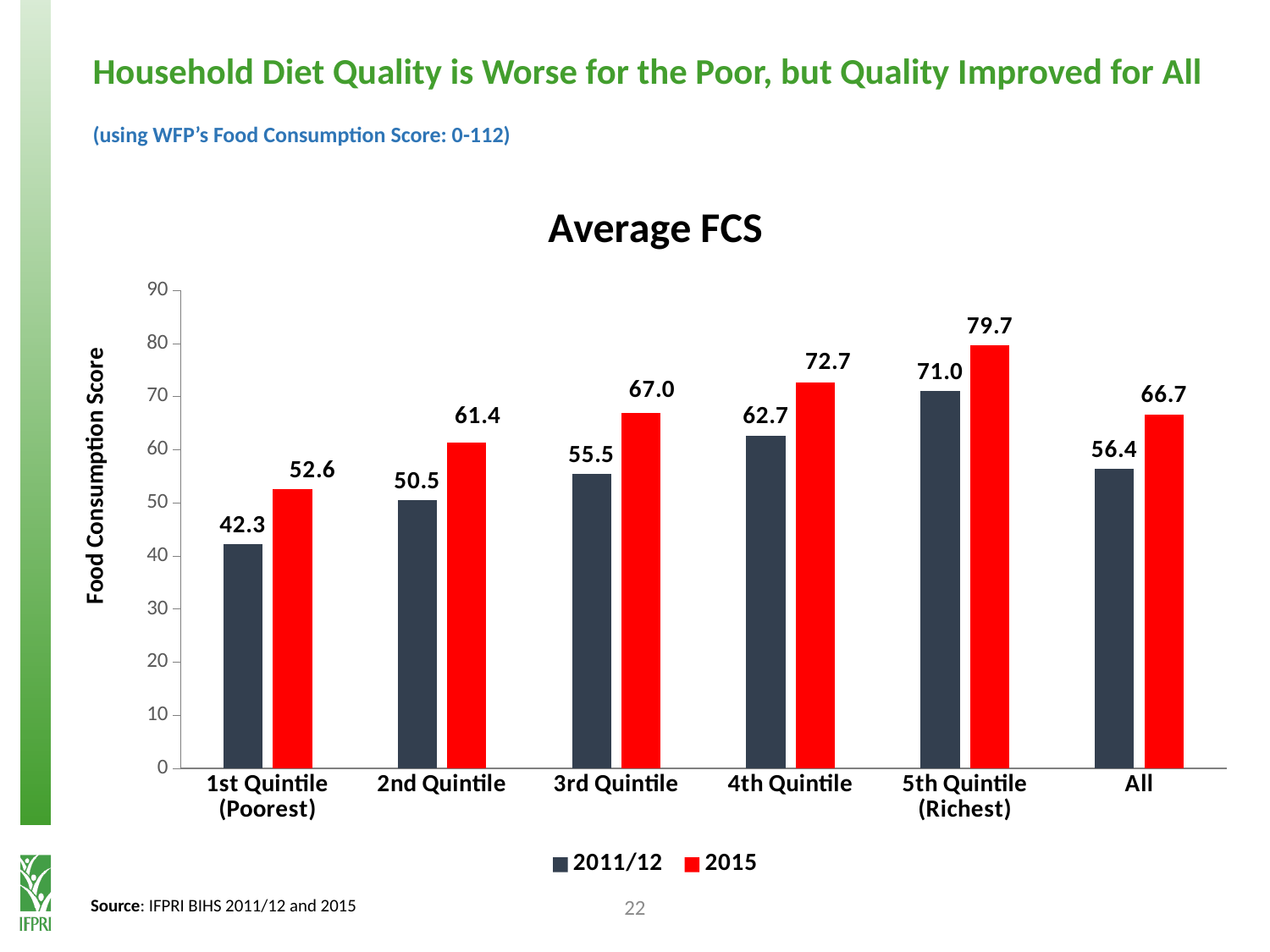
What kind of chart is the Average FCS chart? bar chart What is the 2015 Average FCS value for All households? 66.7 Which category has the lowest 2015 Average FCS value? 1st Quintile (Poorest) Which is larger: the 2015 value for the 2nd Quintile or the 2011/12 value for the 4th Quintile? 2011/12 value for the 4th Quintile How many categories are shown on the x axis of the Average FCS chart? 6 What is the 2011/12 Average FCS value for the 1st Quintile (Poorest)? 42.3 How many series does the legend of the Average FCS chart list? 2 What is the 2015 Average FCS value for the 5th Quintile (Richest)? 79.7 Is the 2011/12 Average FCS value for the 2nd Quintile greater or less than 60? less Which category has the highest 2011/12 Average FCS value? 5th Quintile (Richest) What is the label of the y axis on the Average FCS chart? Food Consumption Score What is the difference between the 2015 and 2011/12 Average FCS values for the 3rd Quintile? 11.5